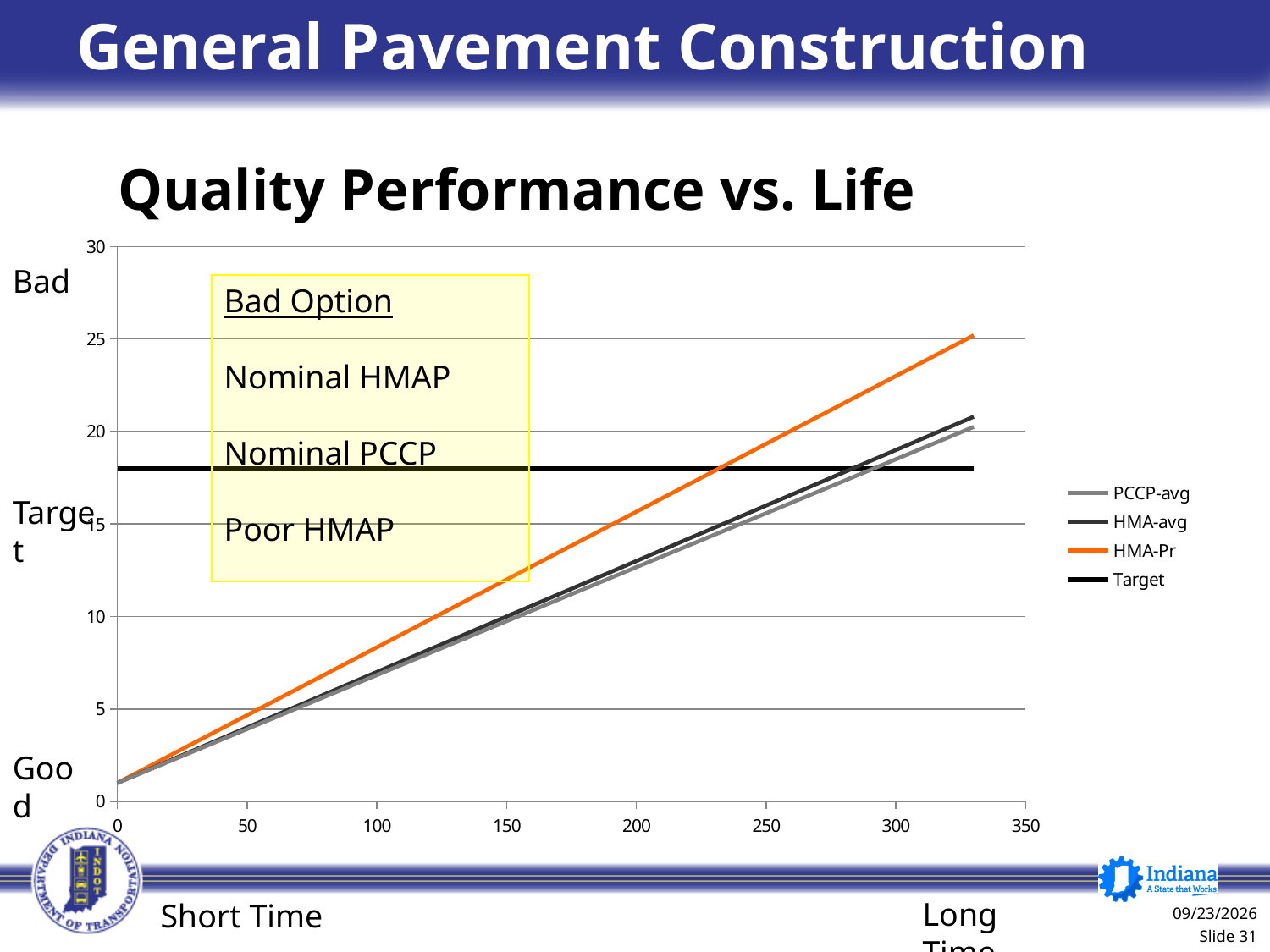
Which series is drawn in orange? HMA-Pr Is the value of the Target line greater or less than 20? less Does the Target series rise, fall or stay flat across the x axis? stay flat What is the title of the chart? Quality Performance vs. Life Is the value of the HMA-Pr series at x = 330 greater or less than 20? greater Which series reaches the highest value at the right end of the chart? HMA-Pr What kind of chart is shown on the slide? line chart At x = 300, which is larger: the HMA-Pr value or the PCCP-avg value? HMA-Pr How many series does the chart legend list? 4 Is the value of the PCCP-avg series at x = 150 greater or less than 15? less Do the values of the HMA-Pr series rise or fall as the x axis increases? rise